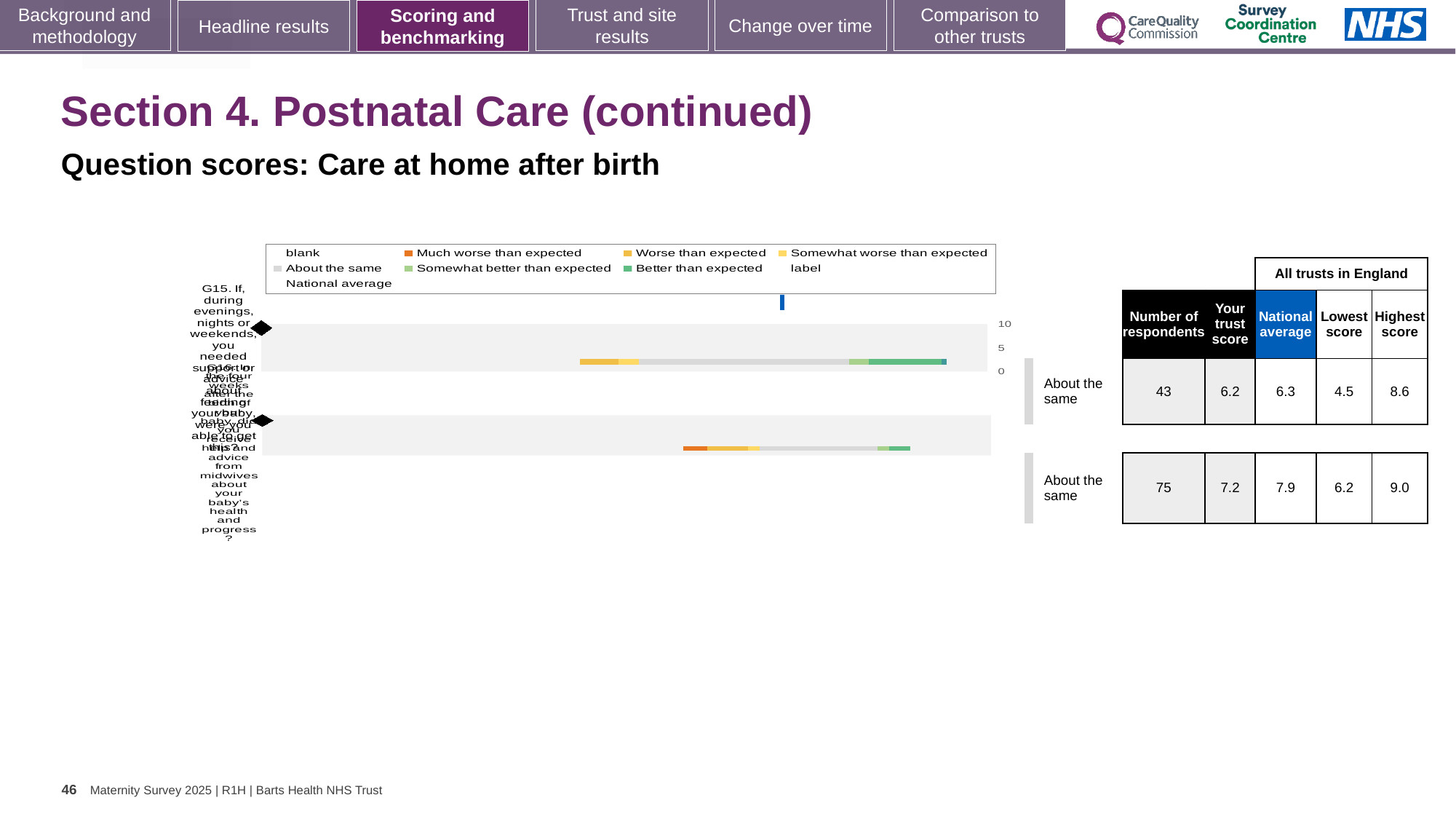
What is the highest tick value shown on the chart's axis? 10 In the chart legend, which colour represents 'Much worse than expected'? orange What is the difference in number of respondents between the second row (G16) and the first row (G15)? 32 In the table, what is 'Your trust score' for the first row (G15)? 6.2 Which row has more respondents, the first row (G15) or the second row (G16)? the second row (G16) What benchmark category is shown for both question rows? About the same In the table, what is the number of respondents for the second row (G16)? 75 How many question rows (bars) are plotted in the chart? 2 In the table, what is the highest score among all trusts in England for the second row (G16)? 9.0 What kind of chart is shown on the slide? bar chart In the table, what is the national average for the second row (G16)? 7.9 In the table, what is the number of respondents for the first row (G15)? 43